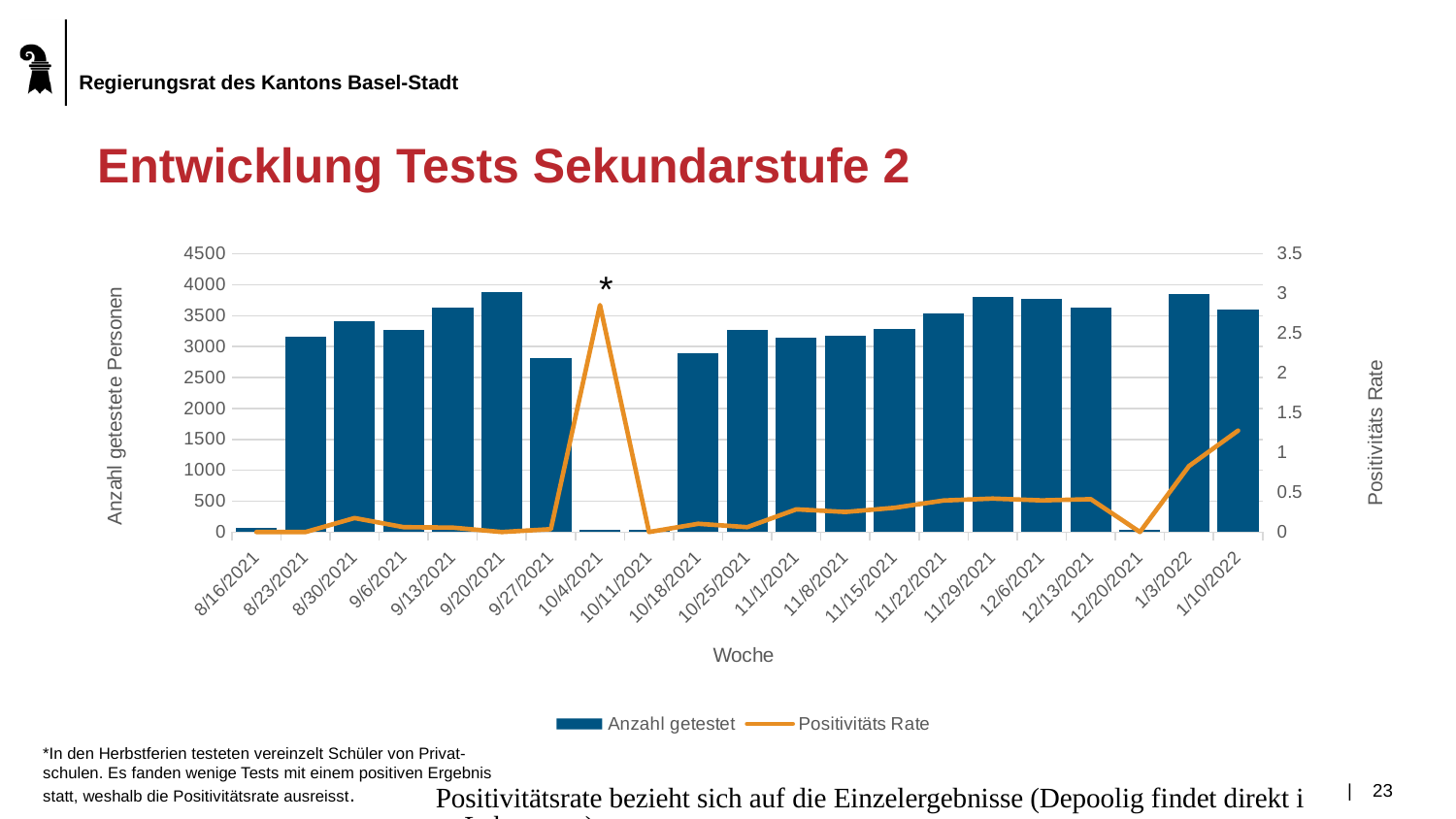
Is the Anzahl getestet value for 9/20/2021 greater or less than 3500? greater Which week has the larger Anzahl getestet, 9/20/2021 or 9/27/2021? 9/20/2021 How many series does the legend list? 2 Is the Positivitäts Rate for 10/4/2021 greater or less than 2.5? greater What kind of chart is this? Combined bar and line chart Which week has the highest Positivitäts Rate? 10/4/2021 What is the title of the chart? Entwicklung Tests Sekundarstufe 2 Is the Positivitäts Rate for 1/10/2022 greater or less than 1? greater How many weeks are shown on the x axis? 21 What is the label of the x axis? Woche